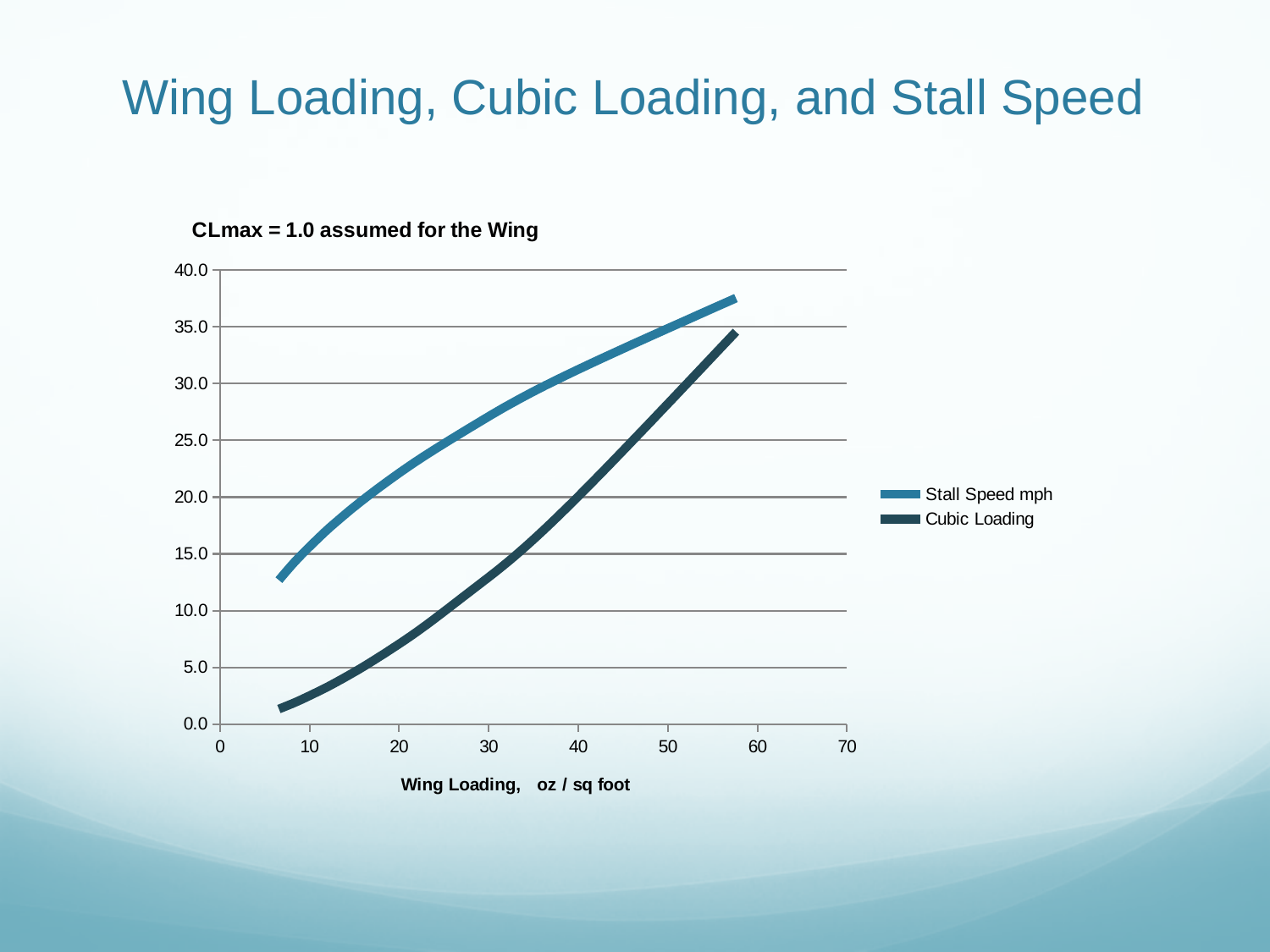
At a wing loading of 20 oz / sq foot, which series has the higher value, Stall Speed mph or Cubic Loading? Stall Speed mph Is the Stall Speed mph value at a wing loading of 40 greater or less than 30.0? greater Is the Cubic Loading value at a wing loading of 30 greater or less than 10.0? greater Is the Cubic Loading value at a wing loading of 20 greater or less than 10.0? less Does the Cubic Loading line rise or fall as wing loading increases? rise Does the Stall Speed mph line rise or fall as wing loading increases? rise What kind of chart is shown on the slide? line chart What is the title printed above the chart? CLmax = 1.0 assumed for the Wing At a wing loading of 40 oz / sq foot, which series has the lower value, Stall Speed mph or Cubic Loading? Cubic Loading What are the two series named in the legend? Stall Speed mph and Cubic Loading How many series does the legend list? 2